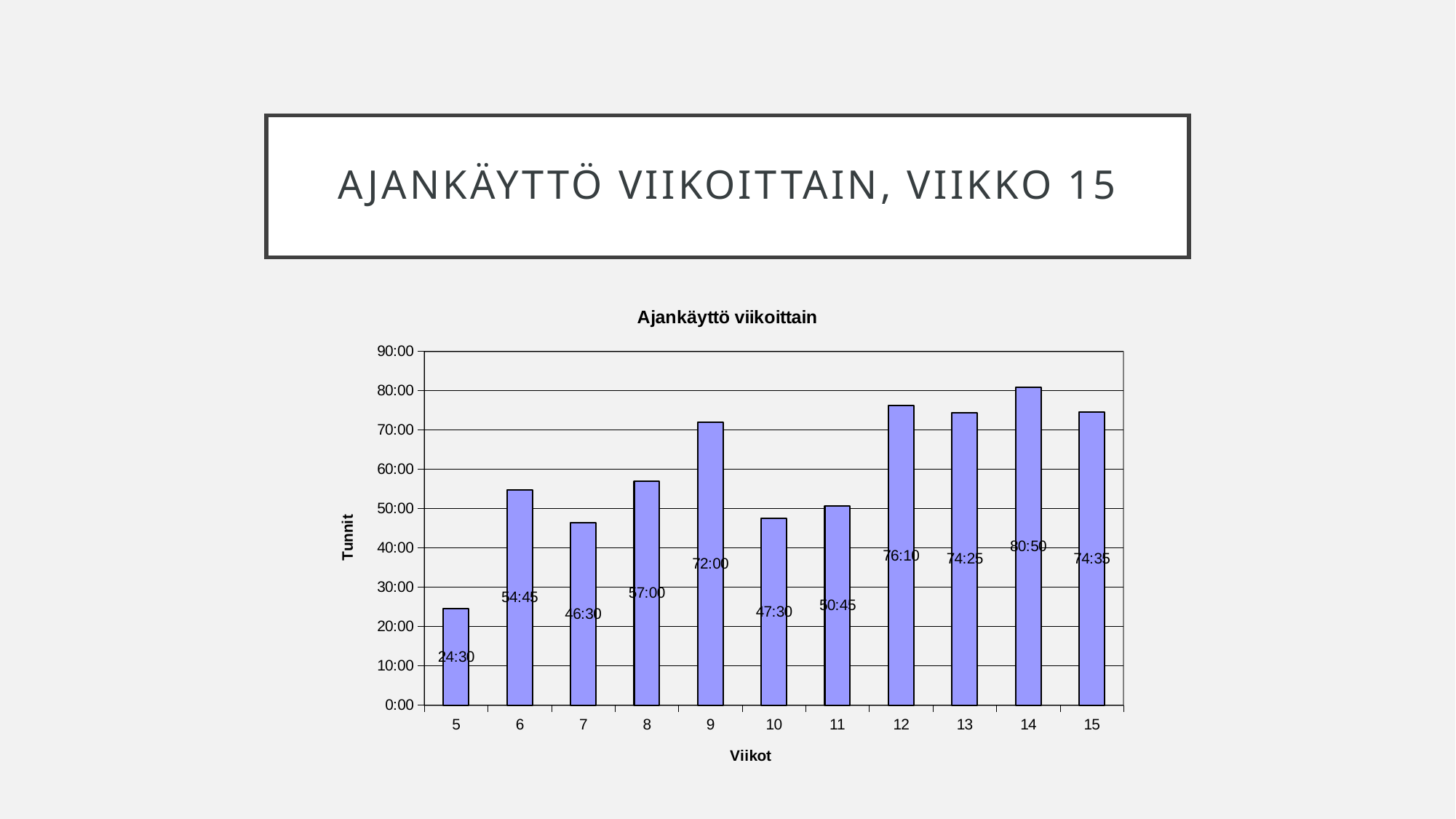
What is the difference between the values for week 9 and week 8? 15:00 What is the value for week 5 in the chart? 24:30 Which has a larger value, week 9 or week 10? week 9 From week 11 to week 12, does the value rise or fall? rise What is the label of the vertical axis of the chart? Tunnit What kind of chart is shown on the slide? bar chart What is the value for week 9 in the chart? 72:00 Which week has the highest value in the chart? 14 How many weeks are plotted in the chart? 11 Which week has the lowest value in the chart? 5 What is the value for week 12 in the chart? 76:10 Is the value for week 5 greater or less than 30:00? less